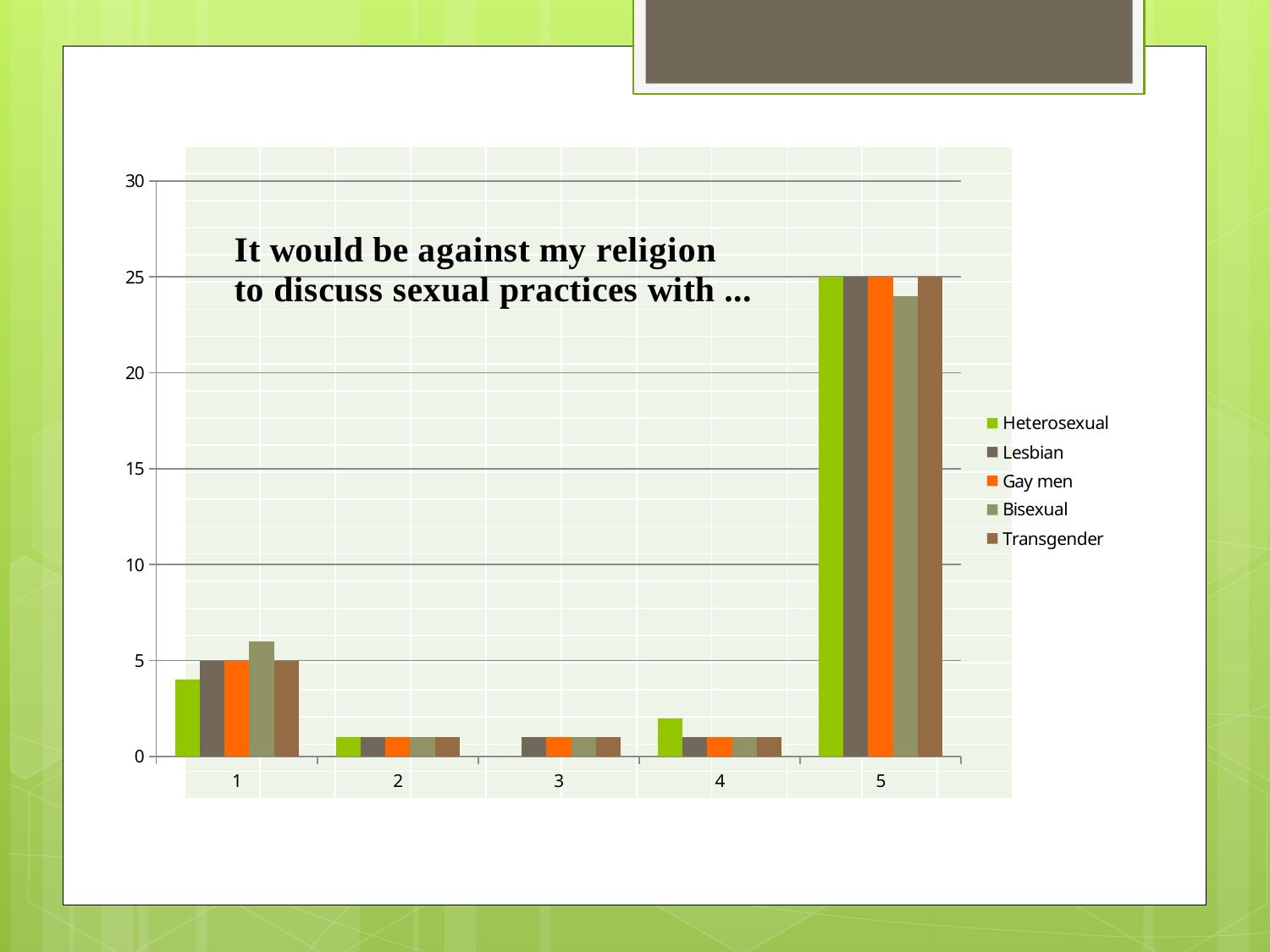
What is the value for Heterosexual in category 5? 25 What is the value for Lesbian in category 1? 5 What kind of chart is shown on the slide? bar chart Which is larger for Heterosexual: the value in category 4 or the value in category 2? category 4 Is the value for Bisexual in category 1 greater or less than 5? greater How many series does the legend list? 5 Which category has the highest value for Gay men? 5 Is the value for Heterosexual in category 1 greater or less than 5? less Which series is listed last in the legend? Transgender Is the value for Transgender in category 5 greater or less than 20? greater What is the title of the chart? It would be against my religion to discuss sexual practices with ... How many categories are shown on the x axis? 5